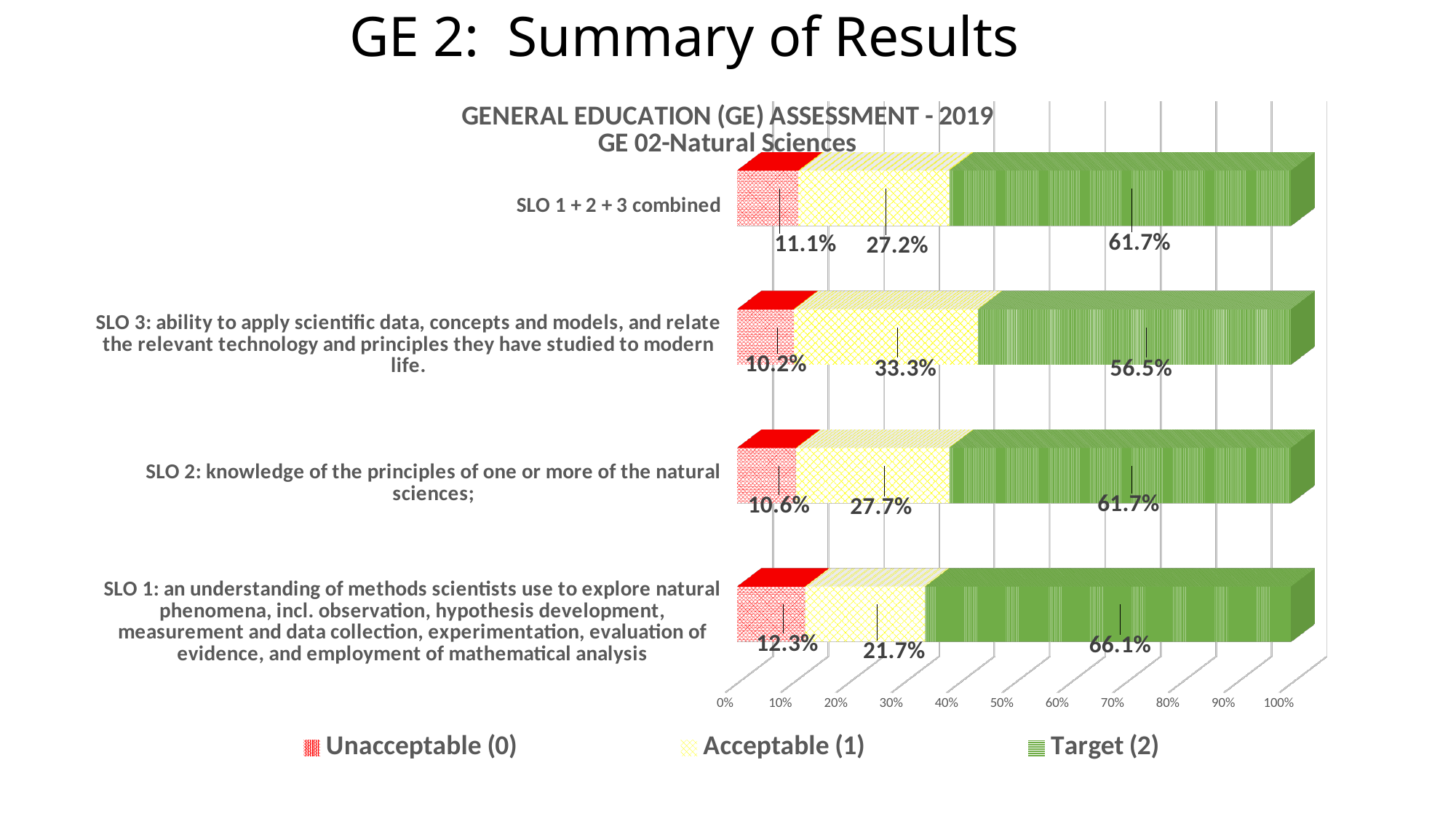
What is the Target (2) value for SLO 1? 66.1% What is the title of the chart? GENERAL EDUCATION (GE) ASSESSMENT - 2019 GE 02-Natural Sciences What is the difference between the Target (2) values for SLO 1 and SLO 3? 9.6% What is the Unacceptable (0) value for SLO 1 + 2 + 3 combined? 11.1% Which category has the highest Target (2) value? SLO 1 Which category has the lowest Unacceptable (0) value? SLO 3 What kind of chart is shown on the slide? Stacked bar chart What is the Acceptable (1) value for SLO 2? 27.7% How many series does the legend list? 3 How many categories (bars) are shown in the chart? 4 Which is larger, the Acceptable (1) value for SLO 3 or for SLO 1? SLO 3 What is the Acceptable (1) value for SLO 3? 33.3%